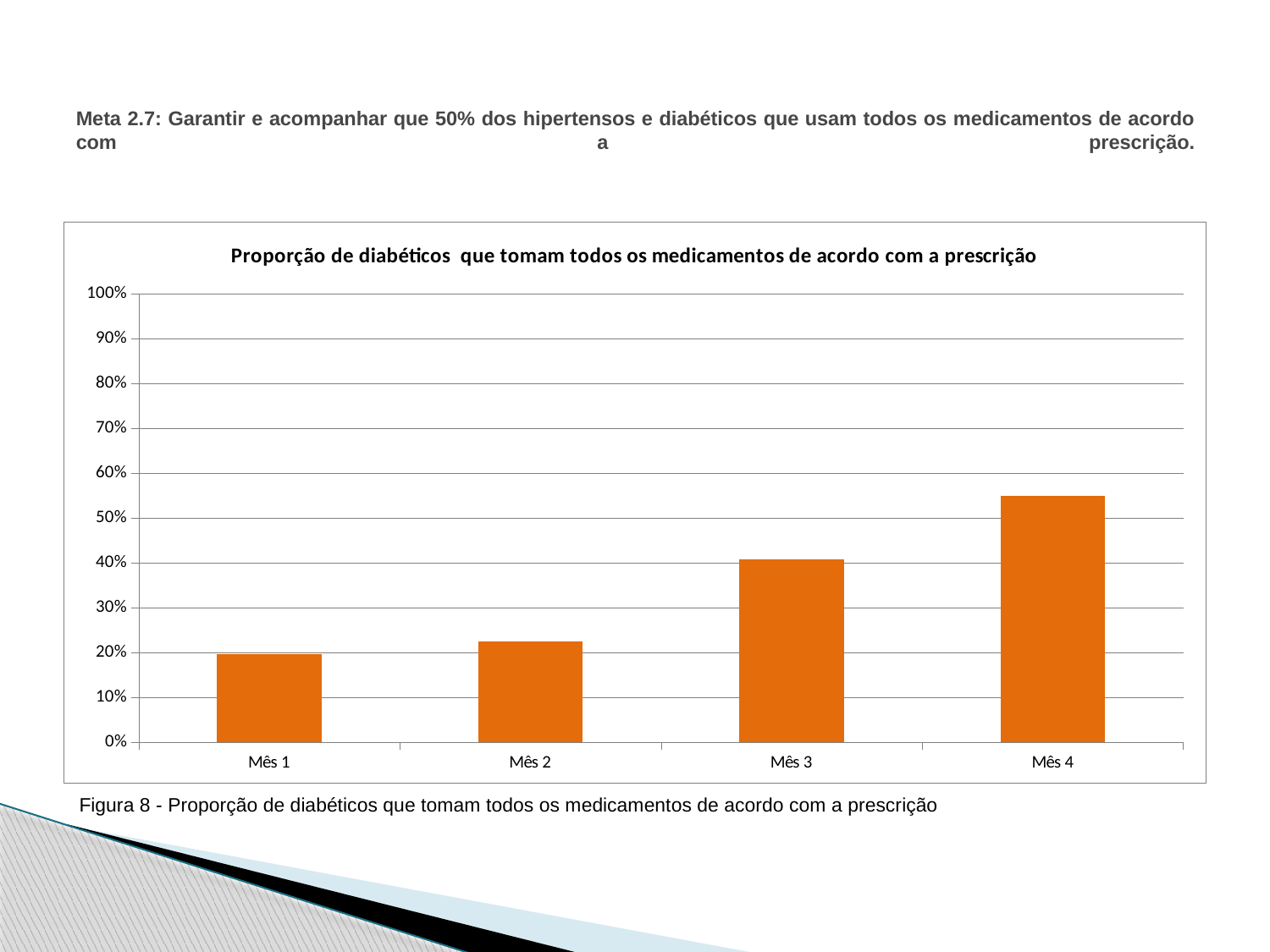
What is the title of the chart? Proporção de diabéticos que tomam todos os medicamentos de acordo com a prescrição What kind of chart is shown on the slide? bar chart Is the value for Mês 4 greater or less than 50%? greater Is the value for Mês 4 greater or less than 60%? less Which is larger, the value for Mês 3 or the value for Mês 2? Mês 3 Which month has the highest proportion of diabetics taking all medications as prescribed? Mês 4 Which is larger, the value for Mês 4 or the value for Mês 1? Mês 4 Which month has the lowest proportion of diabetics taking all medications as prescribed? Mês 1 Is the value for Mês 3 greater or less than 50%? less How many months (categories) are plotted on the chart? 4 Do the values rise or fall from Mês 1 to Mês 4? rise